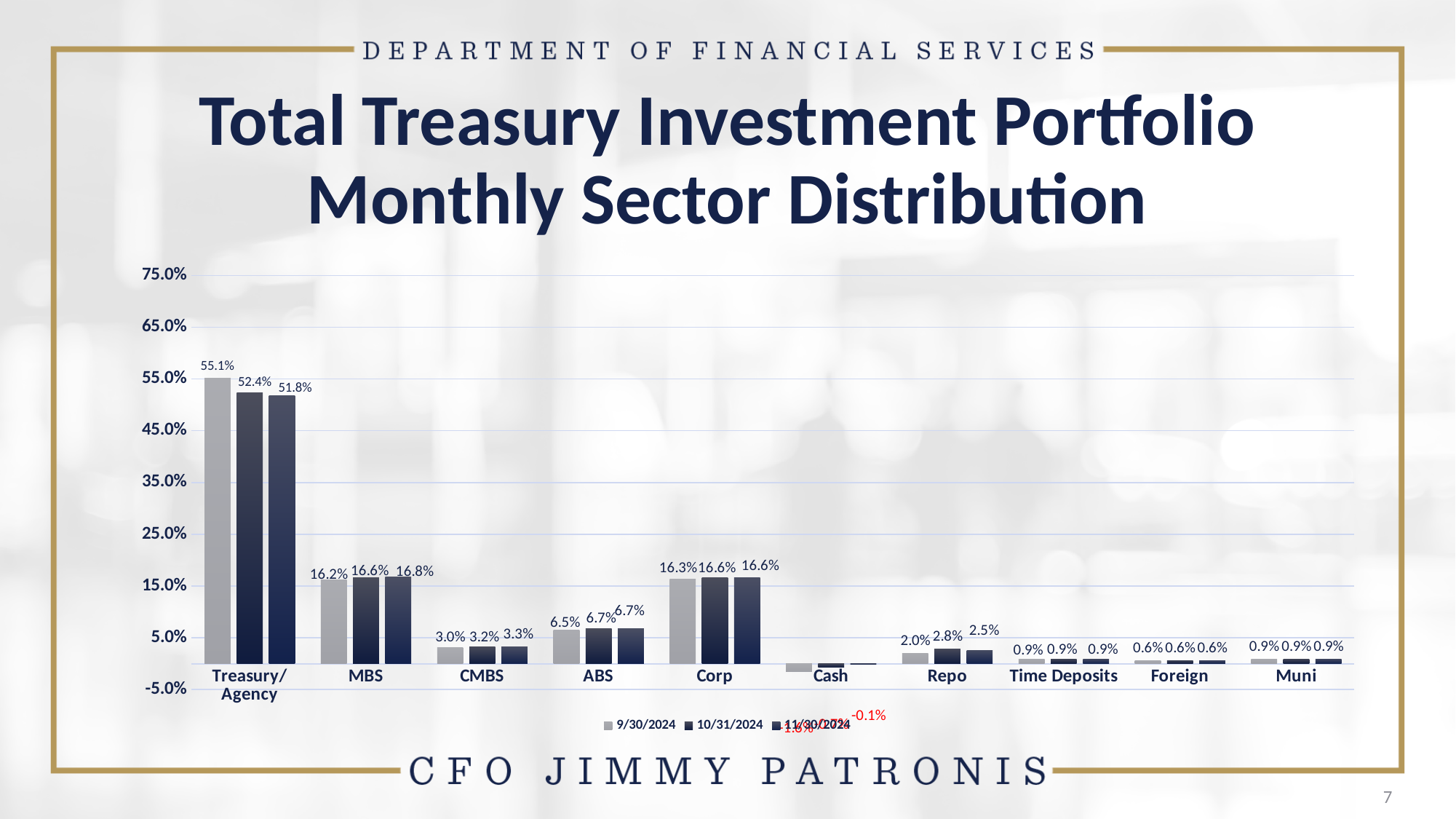
How many sector categories are shown on the x axis? 10 What is the difference between the Treasury/Agency values for 9/30/2024 and 11/30/2024? 3.3% What is the value for ABS for 9/30/2024? 6.5% How many series does the legend list? 3 What is the value for Treasury/Agency for 9/30/2024? 55.1% Which is larger for 9/30/2024: the value for MBS or the value for Corp? Corp What is the value for Repo for 10/31/2024? 2.8% Which sector has the highest value for 11/30/2024? Treasury/Agency What is the value for MBS for 11/30/2024? 16.8% Do the Treasury/Agency values rise or fall from 9/30/2024 to 11/30/2024? Fall What kind of chart is shown on the slide? Bar chart What is the title of the chart? Total Treasury Investment Portfolio Monthly Sector Distribution